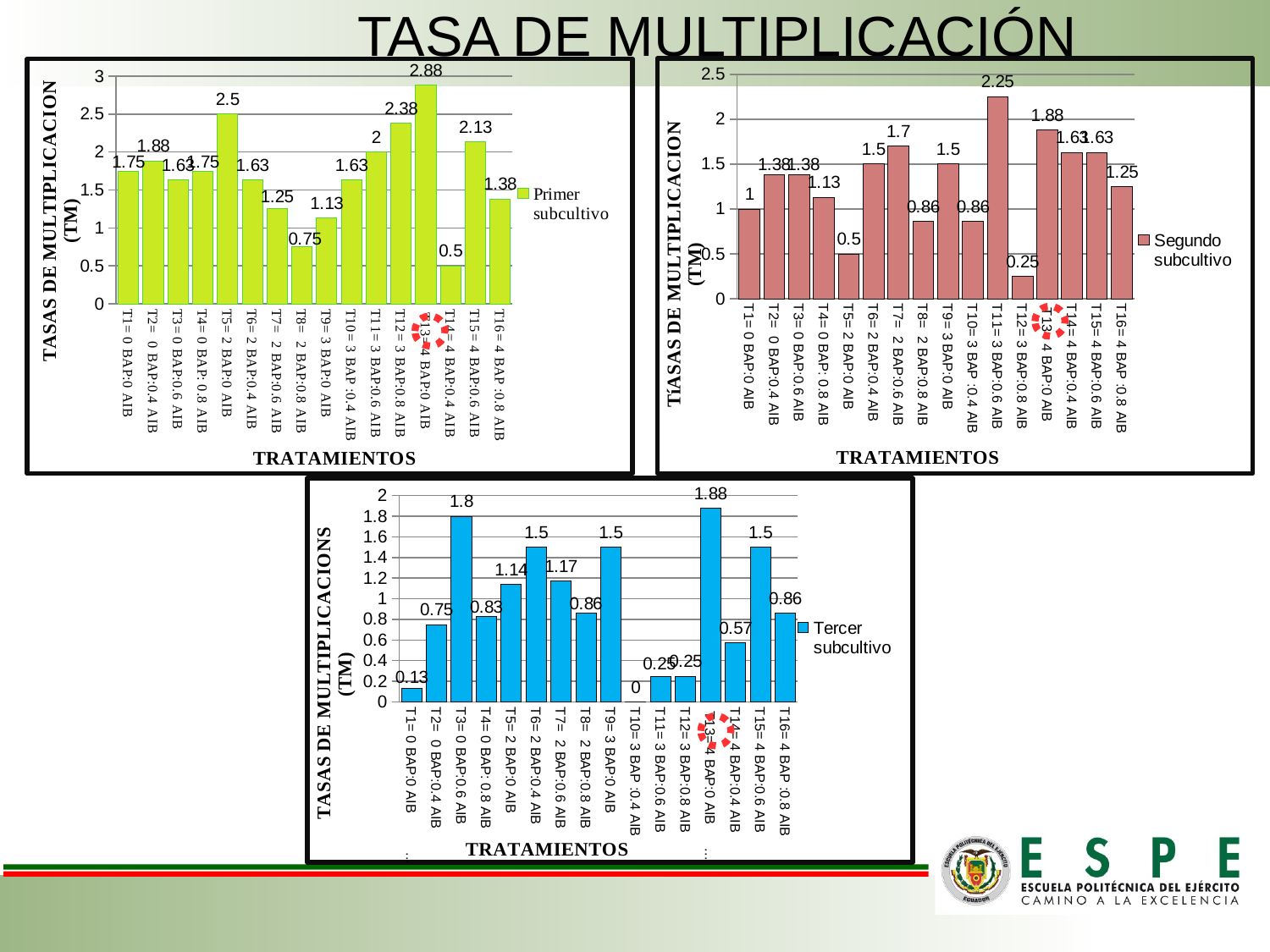
In the Tercer subcultivo chart, which treatment has the lowest value? T10 In the Segundo subcultivo chart, what is the difference between the values for T11 and T12? 2 In the Segundo subcultivo chart, what is the value for T12? 0.25 In the Tercer subcultivo chart, what is the difference between the values for T13 and T14? 1.31 In the Primer subcultivo chart, which treatment has the lowest multiplication rate? T14 In the Segundo subcultivo chart, which is larger, the value for T6 or the value for T7? T7 In the Tercer subcultivo chart, what is the value for T3? 1.8 In the Primer subcultivo chart, what is the difference between the values for T5 and T8? 1.75 What type of chart is the Primer subcultivo chart? Bar chart In the Segundo subcultivo chart, which treatment has the highest value? T11 In the Primer subcultivo chart, what is the value for T13? 2.88 How many treatments are shown on the x axis of the Tercer subcultivo chart? 16